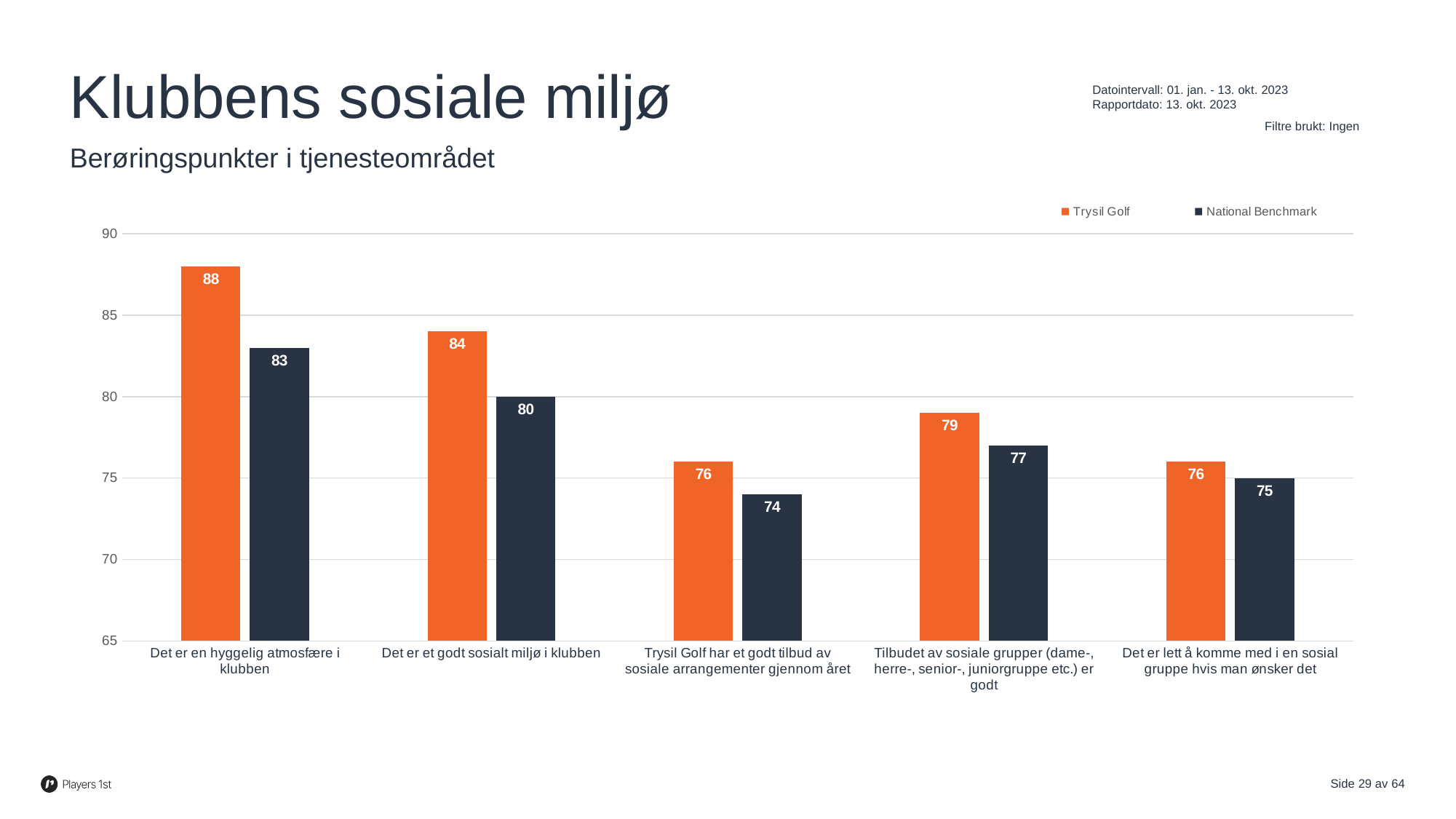
For "Tilbudet av sosiale grupper (dame-, herre-, senior-, juniorgruppe etc.) er godt", which is larger: Trysil Golf or National Benchmark? Trysil Golf What is the difference between the Trysil Golf and National Benchmark values for "Det er et godt sosialt miljø i klubben"? 4 Which category has the lowest National Benchmark value? Trysil Golf har et godt tilbud av sosiale arrangementer gjennom året Which series is shown in orange? Trysil Golf What is the difference between the Trysil Golf and National Benchmark values for "Det er en hyggelig atmosfære i klubben"? 5 How many categories are shown on the x axis? 5 How many series does the legend list? 2 Which category has the highest Trysil Golf value? Det er en hyggelig atmosfære i klubben What is the National Benchmark value for "Trysil Golf har et godt tilbud av sosiale arrangementer gjennom året"? 74 What is the National Benchmark value for "Det er et godt sosialt miljø i klubben"? 80 What is the Trysil Golf value for "Det er en hyggelig atmosfære i klubben"? 88 What kind of chart is shown on the slide? Bar chart